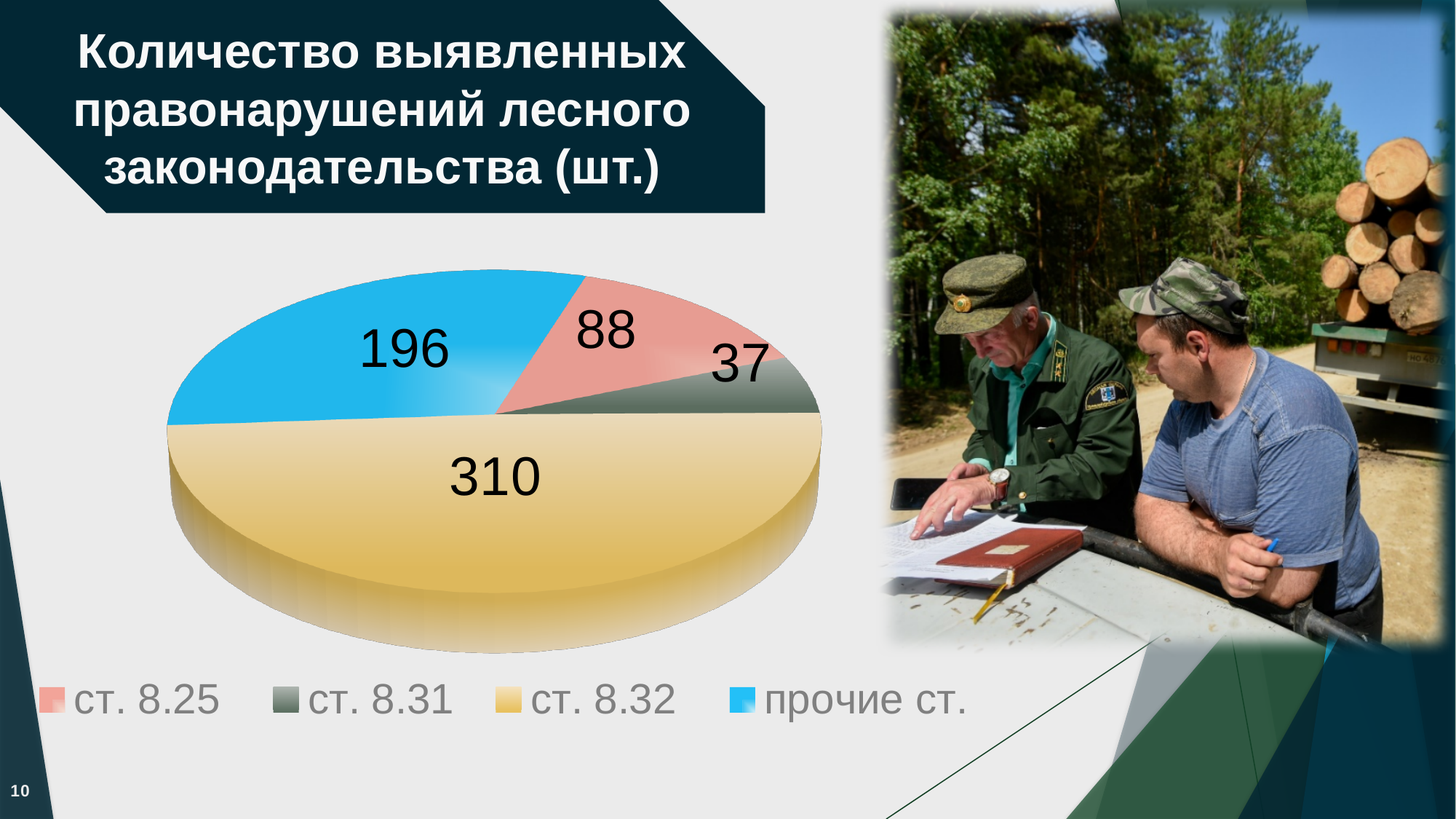
What is the difference between the values for ст. 8.32 and прочие ст.? 114 What type of chart is shown on the slide? pie chart Which is larger, the value for ст. 8.25 or the value for ст. 8.31? ст. 8.25 Which category has the highest value? ст. 8.32 What is the value for ст. 8.32? 310 What is the title of the chart? Количество выявленных правонарушений лесного законодательства (шт.) What is the value for ст. 8.25? 88 Which category has the lowest value? ст. 8.31 What is the value for ст. 8.31? 37 What is the total of all slices in the pie chart? 631 What is the value for прочие ст.? 196 How many categories does the pie chart have? 4